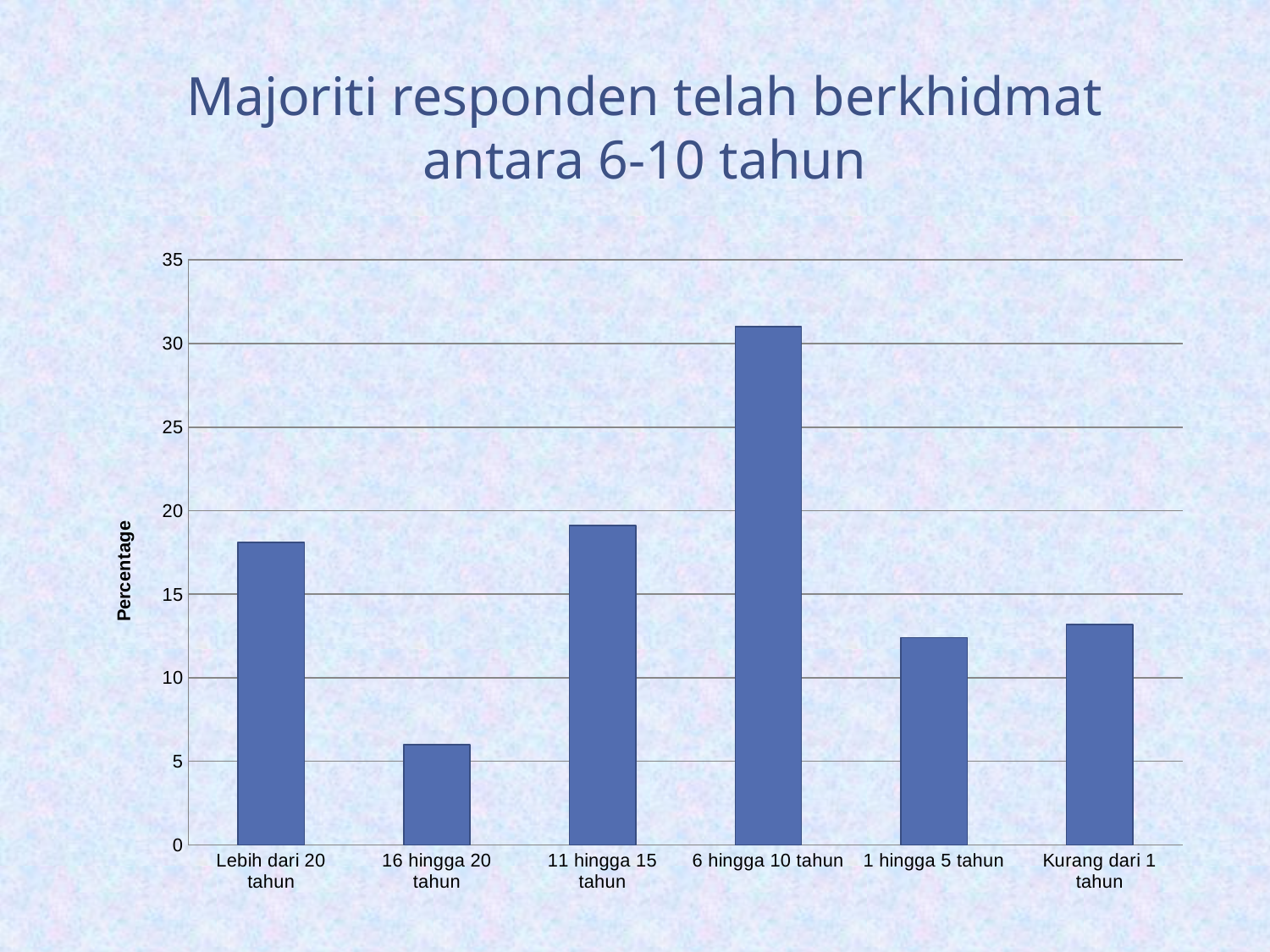
Is the value for Lebih dari 20 tahun greater or less than 20? less What is the label on the vertical axis of the chart? Percentage Which category has the highest value in the chart? 6 hingga 10 tahun How many categories are shown on the x axis of the chart? 6 What kind of chart is shown on the slide? bar chart Which is larger, the value for 6 hingga 10 tahun or the value for Lebih dari 20 tahun? 6 hingga 10 tahun Is the value for 1 hingga 5 tahun greater or less than 10? greater Is the value for Kurang dari 1 tahun greater or less than 15? less Which category has the lowest value in the chart? 16 hingga 20 tahun Which is larger, the value for 16 hingga 20 tahun or the value for 1 hingga 5 tahun? 1 hingga 5 tahun